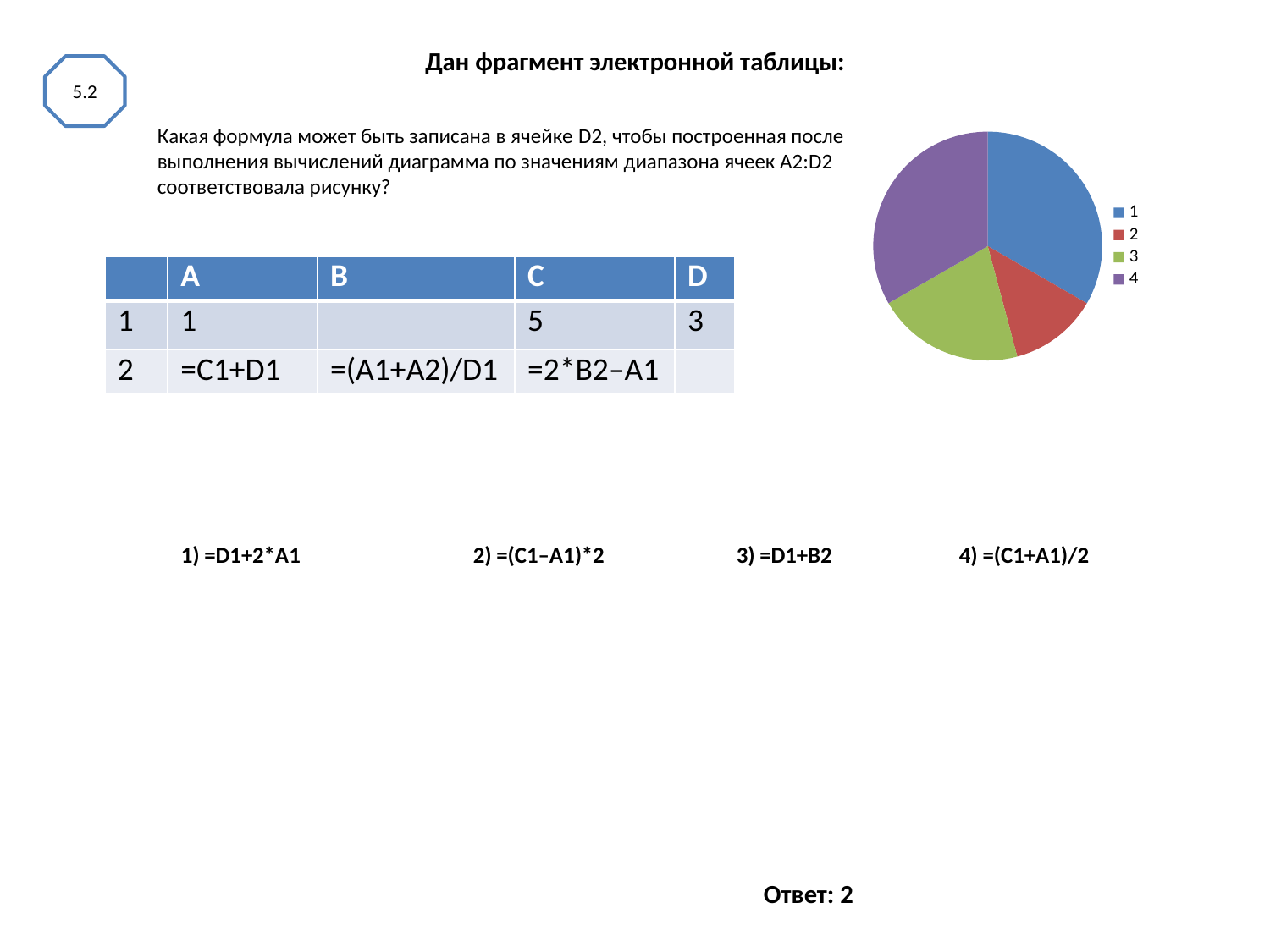
How many slices does the pie chart have? 4 Which legend entry corresponds to the purple slice of the pie chart? 4 What kind of chart is shown on the slide? pie chart Which slice is larger in the pie chart, slice 3 or slice 2? 3 Which slice is larger in the pie chart, slice 4 or slice 2? 4 Which slice is larger in the pie chart, slice 1 or slice 2? 1 Which slice of the pie chart is the smallest? 2 How many entries does the legend of the pie chart list? 4 What colour is slice 2 in the pie chart? red